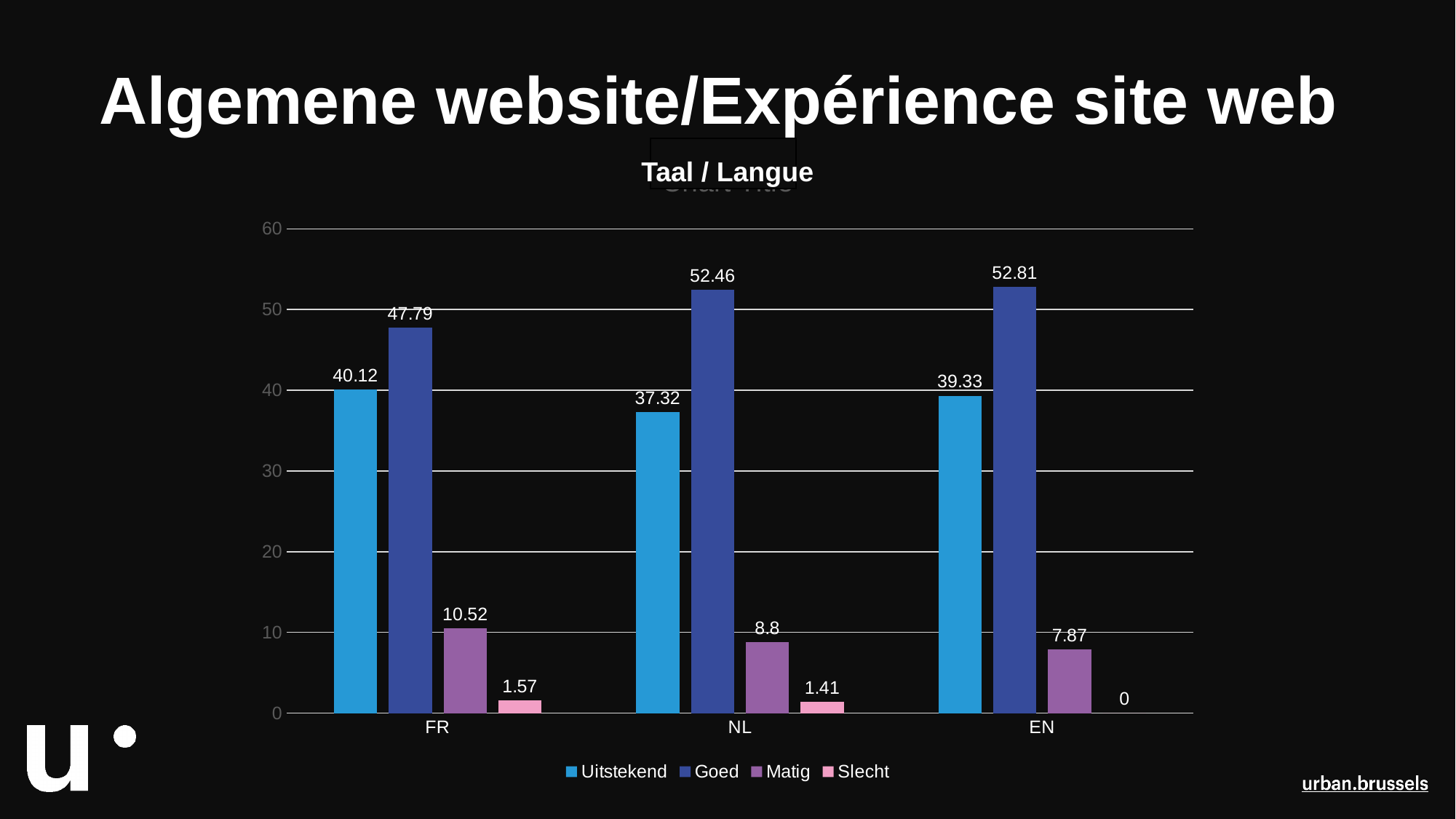
How many categories are shown on the x axis? 3 Which category has the highest value for Goed? EN What is the difference between the Goed and Uitstekend values in the FR category? 7.67 What is the title of the chart? Taal / Langue What is the value for Slecht in the EN category? 0 What is the value for Goed in the NL category? 52.46 What is the value for Matig in the NL category? 8.8 What is the value for Uitstekend in the FR category? 40.12 How many series does the legend list? 4 Which is larger in the EN category, Uitstekend or Goed? Goed What kind of chart is shown on the slide? Bar chart Which category has the lowest value for Uitstekend? NL